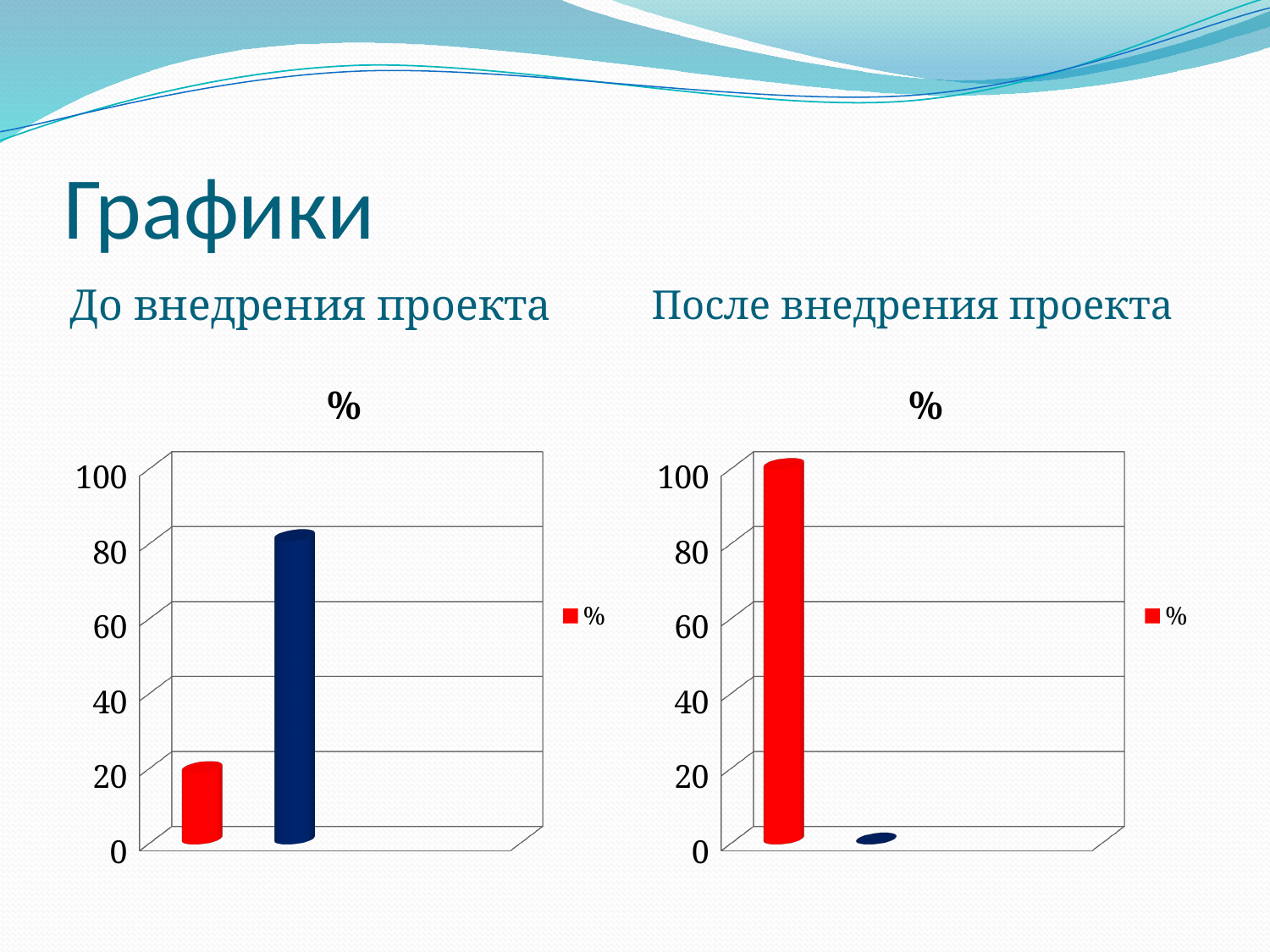
In the chart under "До внедрения проекта", is the value of the red bar greater or less than 40? less In the chart under "До внедрения проекта", is the value of the dark blue bar greater or less than 60? greater What kind of chart is the chart under "После внедрения проекта"? bar chart In the chart under "До внедрения проекта", which bar is taller, the red one or the dark blue one? the dark blue one In the chart under "До внедрения проекта", how many bars are plotted? 2 What kind of chart is the chart under "До внедрения проекта"? bar chart In the chart under "После внедрения проекта", how many bars are plotted? 2 In the chart under "После внедрения проекта", is the value of the dark blue bar greater or less than 20? less What is the title shown above each of the two charts? % In the chart under "После внедрения проекта", which bar is the highest, the red one or the dark blue one? the red one In the chart under "До внедрения проекта", how many series does the legend list? 1